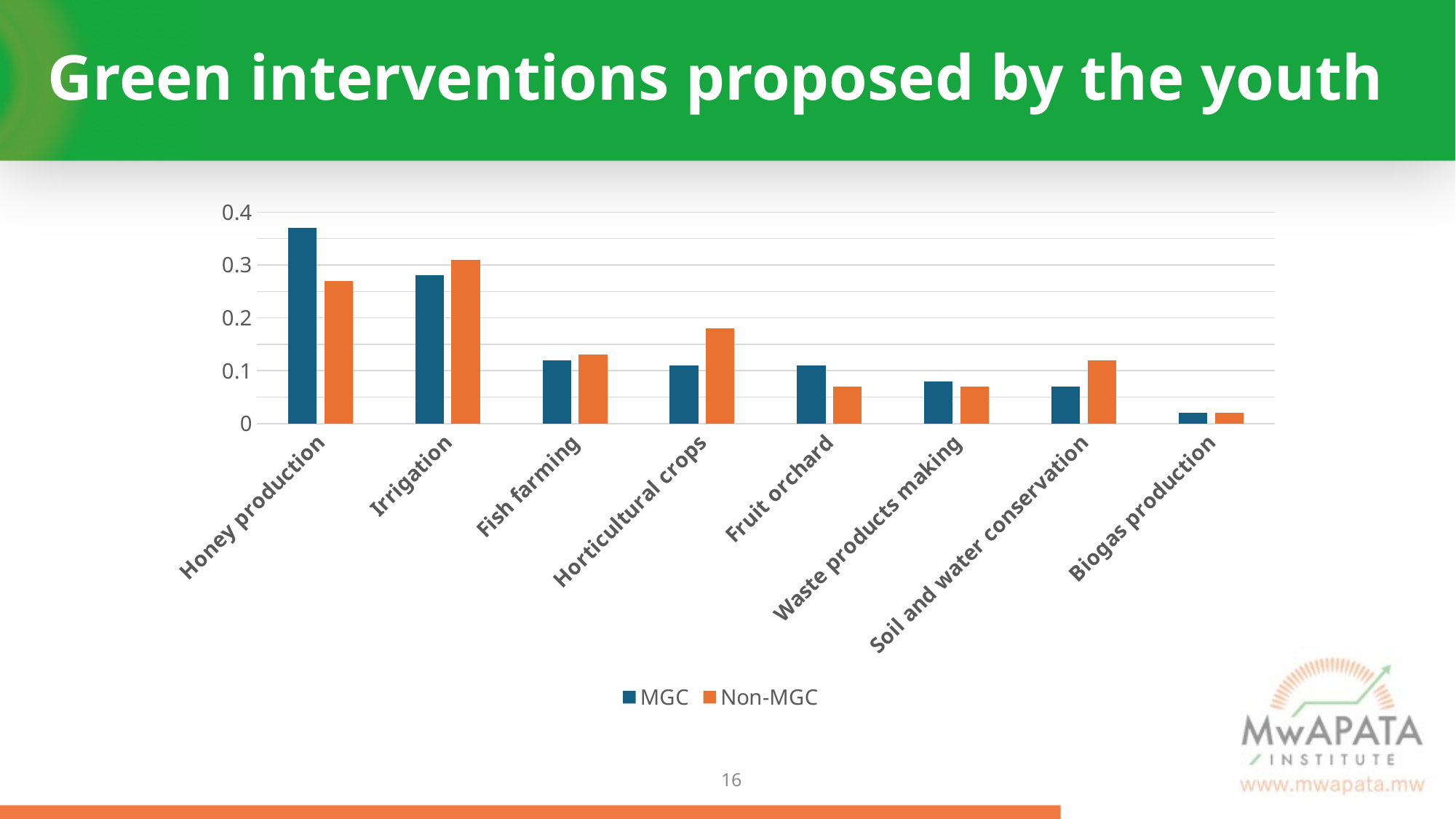
How many series does the legend list? 2 What kind of chart is shown on the slide? bar chart Which category has the lowest MGC value? Biogas production Is the MGC value for Honey production greater or less than 0.3? greater For Honey production, which series has the larger value, MGC or Non-MGC? MGC Is the Non-MGC value for Fruit orchard greater or less than 0.1? less Which category has the highest MGC value? Honey production Is the Non-MGC value for Horticultural crops greater or less than 0.2? less How many intervention categories are shown on the x axis? 8 What are the two entries in the chart legend? MGC and Non-MGC For Soil and water conservation, which series has the larger value, MGC or Non-MGC? Non-MGC Which category has the highest Non-MGC value? Irrigation